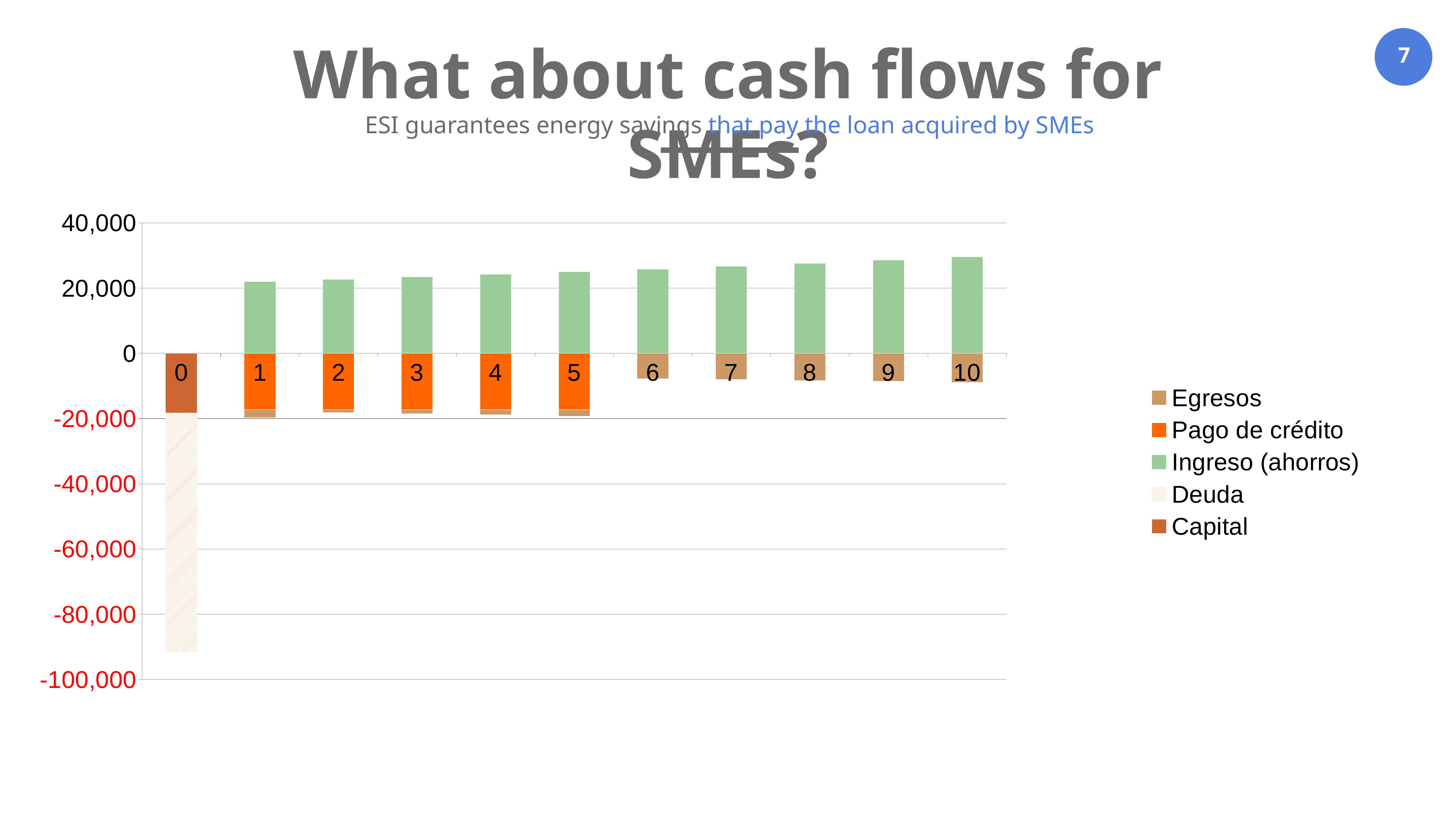
What kind of chart is shown on the slide? stacked bar chart In which year is the Ingreso (ahorros) bar the lowest? 1 How many categories (years) are shown on the x axis of the chart? 11 Which colour represents Pago de crédito in the chart? orange Which is larger, the Ingreso (ahorros) value for year 10 or for year 1? year 10 How many series does the chart legend list? 5 Does the Ingreso (ahorros) series rise or fall from year 1 to year 10? rise In how many years does the Pago de crédito series appear in the chart? 5 Is the Ingreso (ahorros) value for year 10 greater or less than 20,000? greater In which year is the Ingreso (ahorros) bar the highest? 10 Which series are listed in the chart legend? Egresos, Pago de crédito, Ingreso (ahorros), Deuda, Capital Is the Deuda value for year 0 greater or less than -80,000? greater